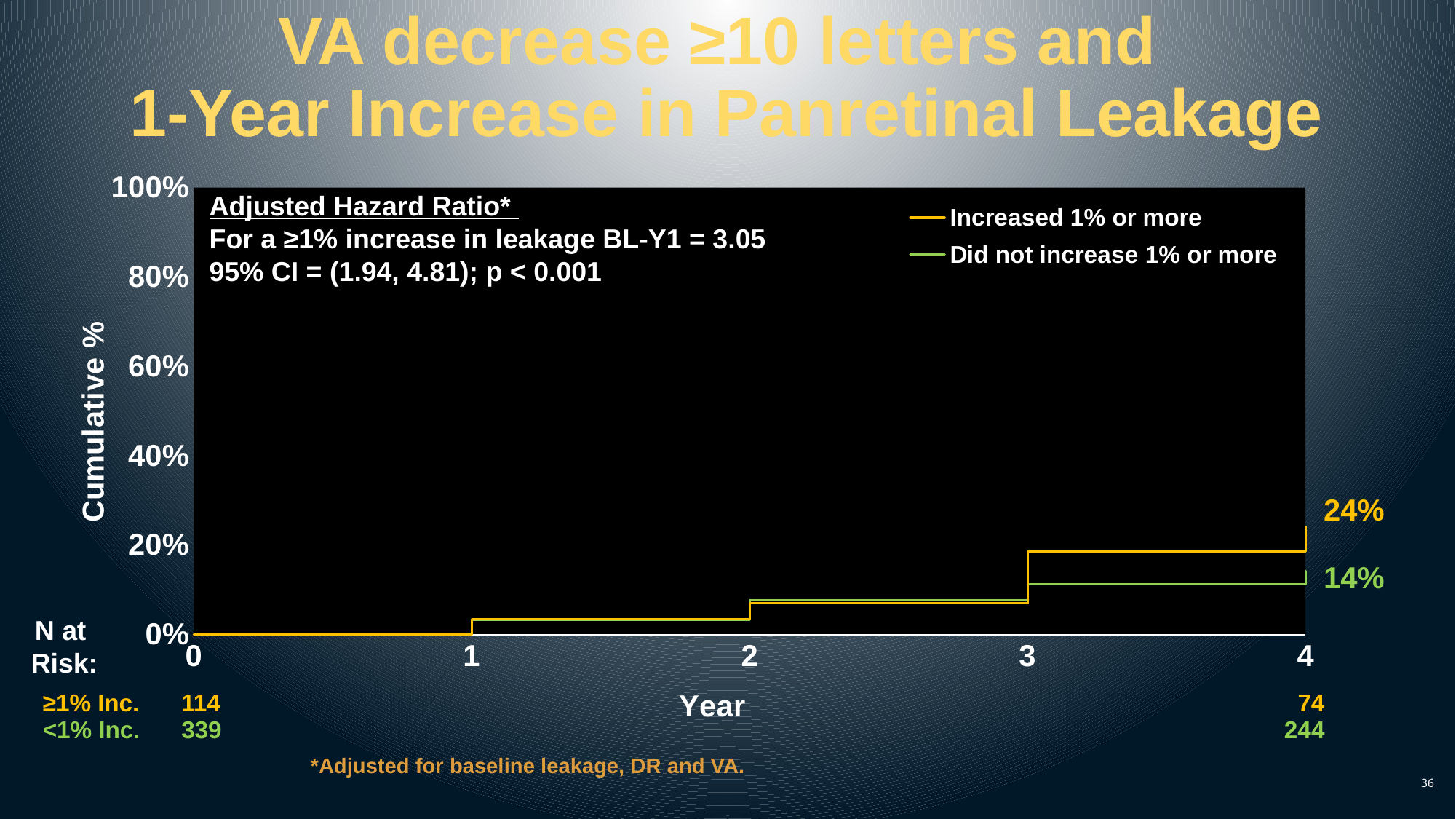
What is the label of the y-axis? Cumulative % What is the cumulative % at year 4 for the 'Increased 1% or more' group? 24% How many series does the legend list? 2 Do the cumulative % values rise or fall as the year increases? Rise Which group has the higher cumulative % at year 4? Increased 1% or more What is the cumulative % at year 4 for the 'Did not increase 1% or more' group? 14% What is the number at risk at year 4 for the <1% Inc. group? 244 Is the year-4 cumulative % for the 'Increased 1% or more' group greater or less than 20%? greater Is the year-4 cumulative % for the 'Did not increase 1% or more' group greater or less than 20%? less What is the number at risk at year 0 for the ≥1% Inc. group? 114 What is the difference between the year-4 cumulative % of the 'Increased 1% or more' group and the 'Did not increase 1% or more' group? 10% What kind of chart is shown on the slide? Line chart (step / cumulative incidence curve)